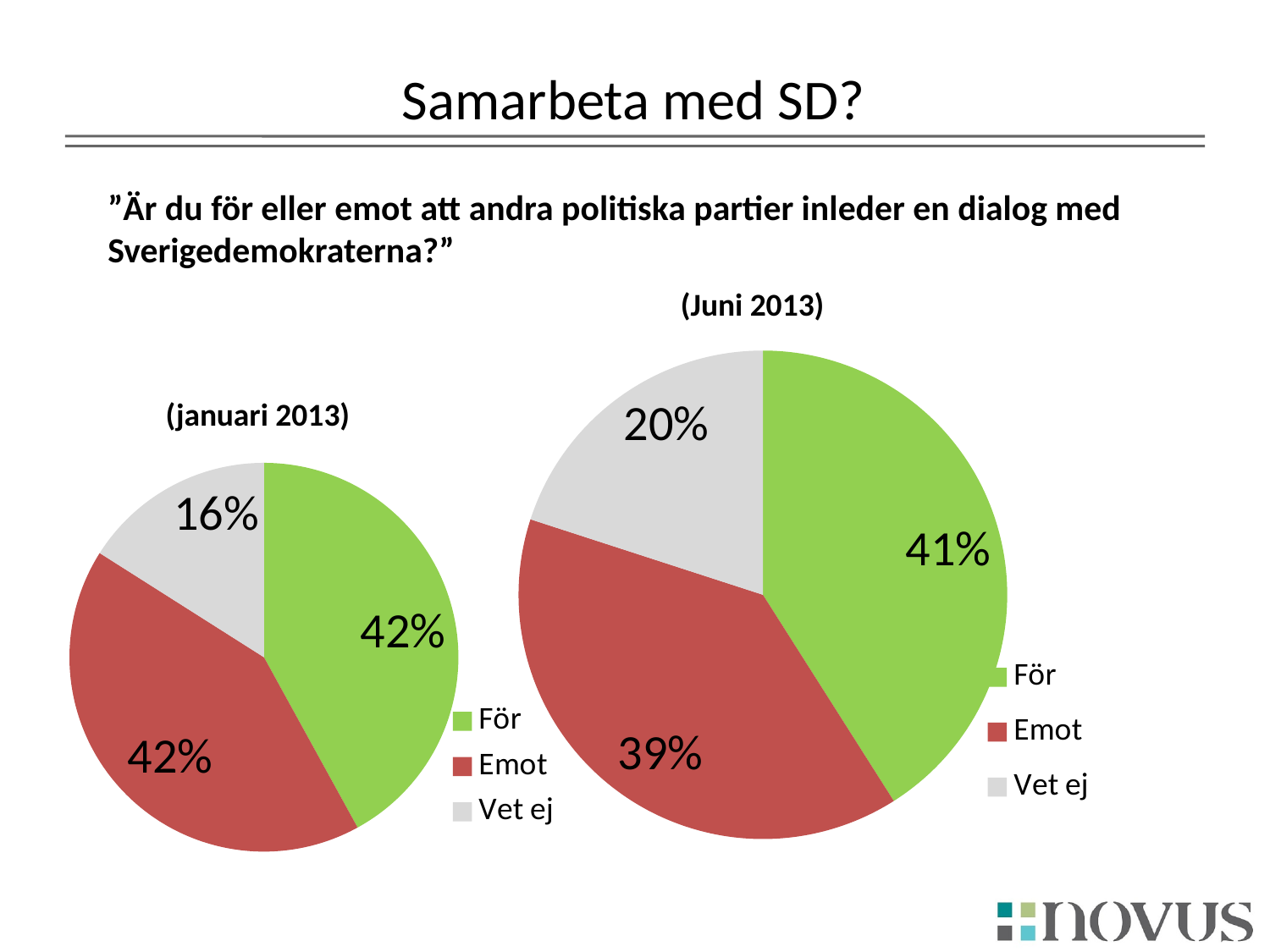
In the (Juni 2013) pie chart, which category has the largest slice? För In the (Juni 2013) pie chart, which category has the smallest slice? Vet ej In the (januari 2013) pie chart, which category has the smallest slice? Vet ej How many entries does the legend of the (Juni 2013) pie chart list? 3 In the (januari 2013) pie chart, what share is labelled for För? 42% What kind of chart is the (Juni 2013) chart? Pie chart In the (januari 2013) pie chart, what share is labelled for Vet ej? 16% How many slices does the (januari 2013) pie chart have? 3 In the (Juni 2013) pie chart, what is the difference between the För and Vet ej shares? 21% In the (januari 2013) pie chart, what is the difference between the Emot and Vet ej shares? 26% In the (Juni 2013) pie chart, what share is labelled for För? 41% In the (Juni 2013) pie chart, what share is labelled for Emot? 39%